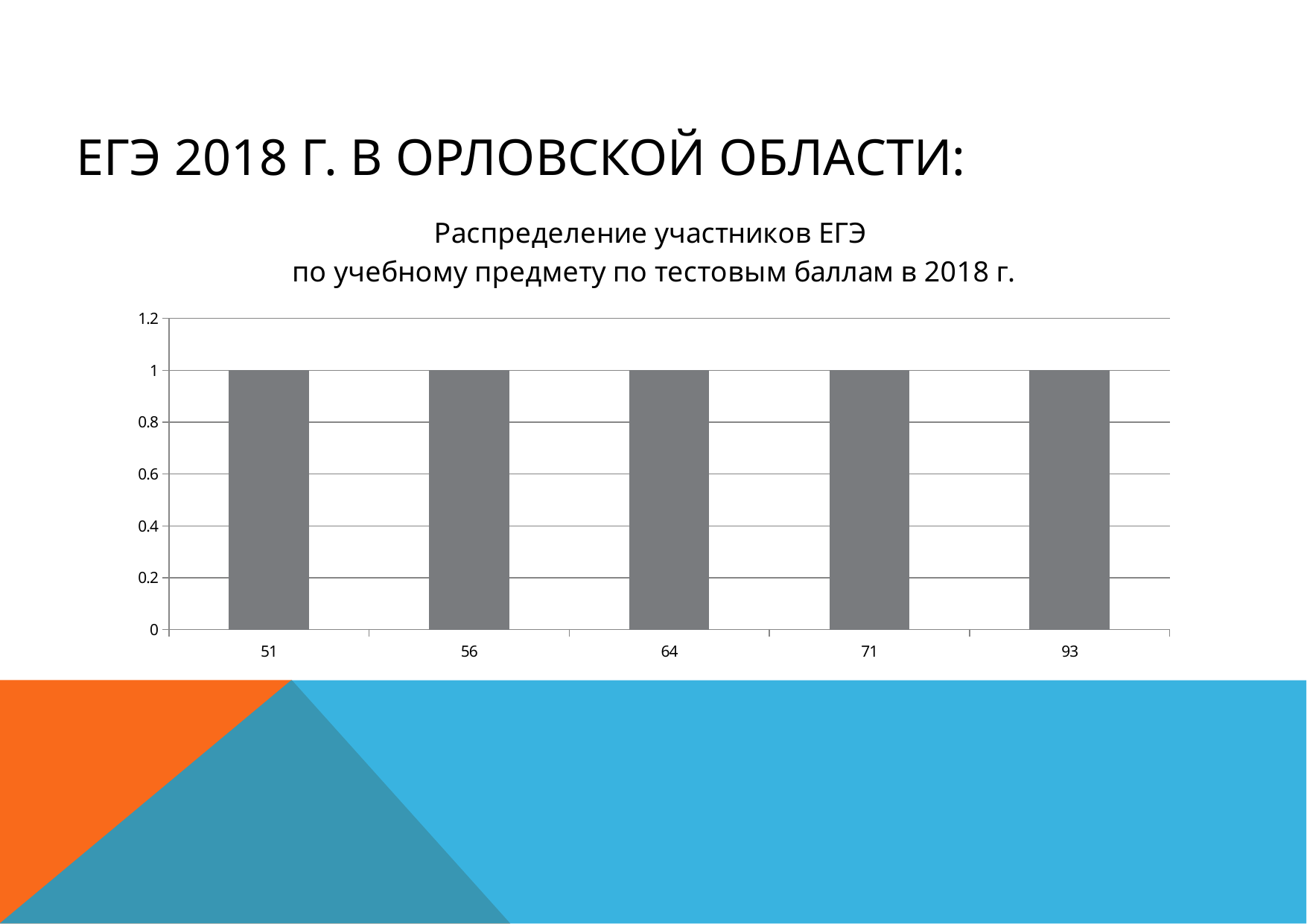
Is the value for category 71 greater or less than 1.2? less What is the value of the bar for category 64? 1 What kind of chart is shown on the slide? bar chart Is the value for category 56 greater or less than 0.8? greater Do the bar values rise, fall, or stay flat from left to right along the x axis? stay flat What is the value of the bar for category 51? 1 What is the label of the leftmost category on the x axis? 51 How many categories are shown on the x axis of the chart? 5 What is the difference between the values for categories 51 and 93? 0 What is the highest value shown on the vertical axis? 1.2 What is the value of the bar for category 93? 1 What is the title of the chart? Распределение участников ЕГЭ по учебному предмету по тестовым баллам в 2018 г.